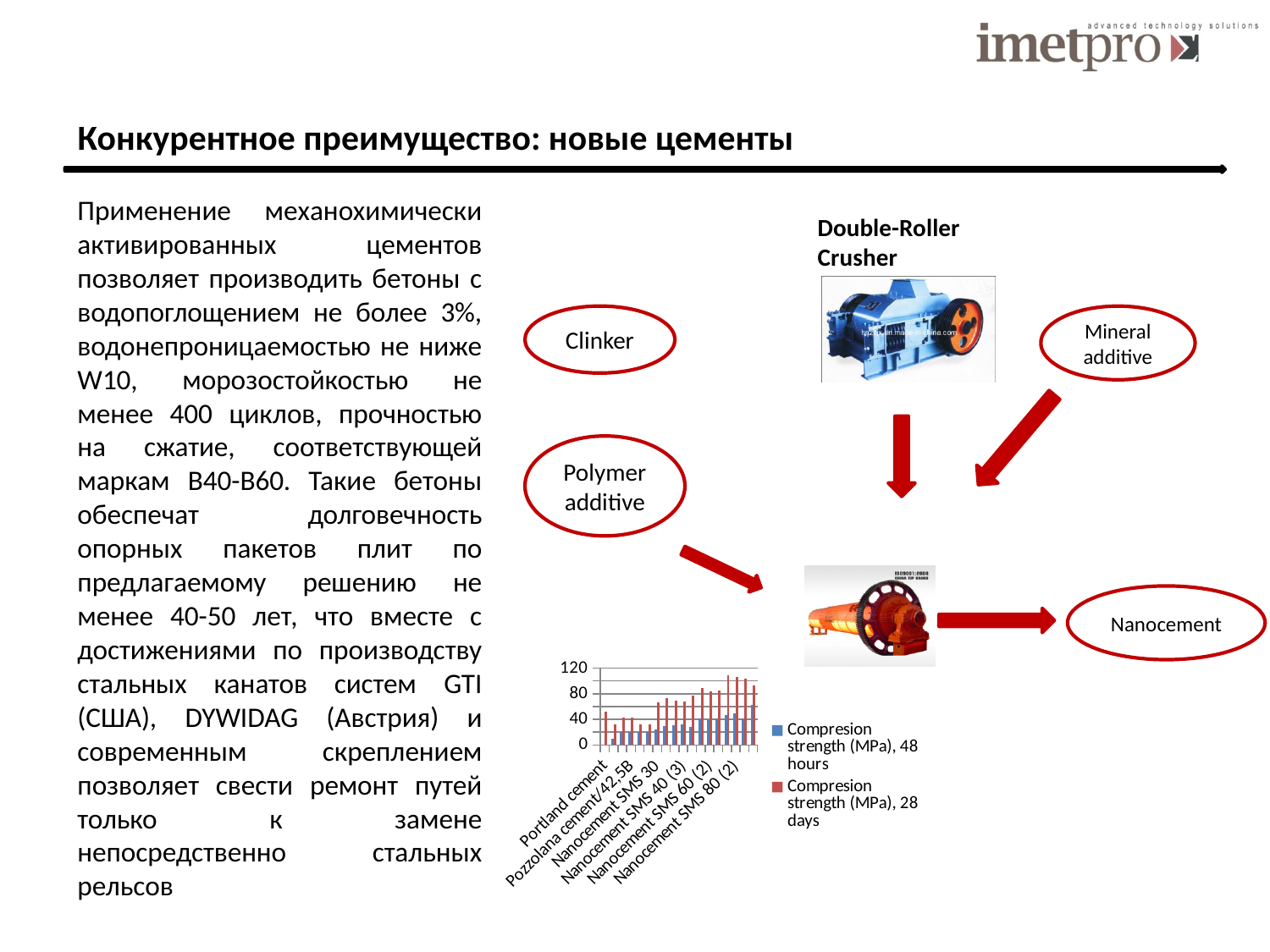
What kind of chart is shown at the bottom of the slide? bar chart Which series in the bar chart is shown in red? Compresion strength (MPa), 28 days How many series does the legend of the bar chart list? 2 What is the highest value shown on the vertical axis of the bar chart? 120 In the bar chart, is the 28-day compression strength for Nanocement SMS 80 (2) greater or less than 80? greater In the bar chart, is the 28-day compression strength for Portland cement greater or less than 40? greater Which series in the bar chart is shown in blue? Compresion strength (MPa), 48 hours In the bar chart, which series has the larger value for Portland cement, 48 hours or 28 days? 28 days In the bar chart, is the 48-hour compression strength for Nanocement SMS 80 (2) greater or less than 80? less In the bar chart, do the 28-day compression strength values generally rise or fall from left to right along the x axis? rise